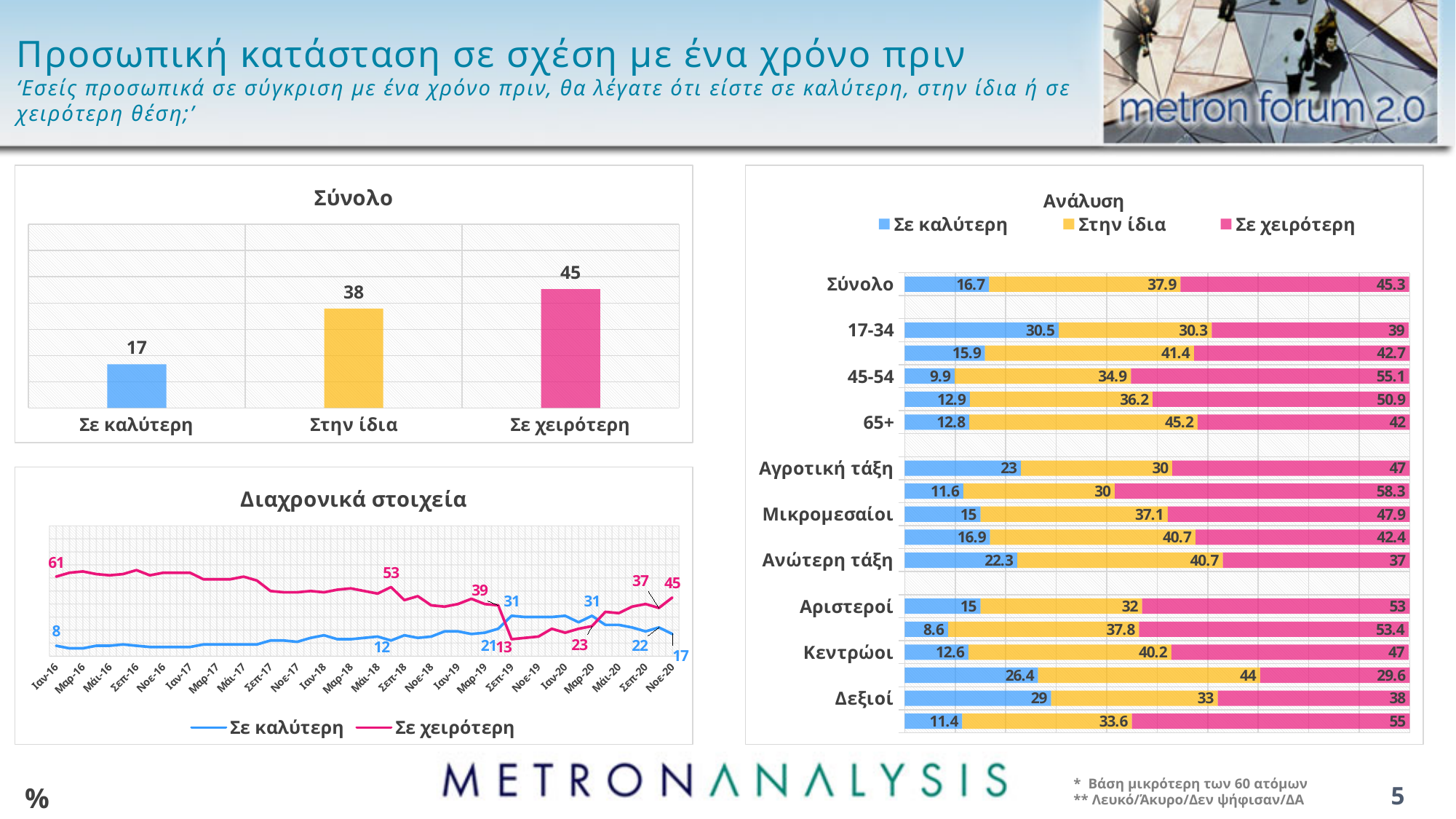
What kind of chart is the 'Σύνολο' chart? bar chart In the 'Διαχρονικά στοιχεία' chart, what is the value of 'Σε χειρότερη' at Ιαν-16? 61 In the 'Ανάλυση' chart, what is the 'Στην ίδια' value for 'Σύνολο'? 37.9 In the 'Ανάλυση' chart, which has the larger 'Σε χειρότερη' value, 'Αριστεροί' or 'Δεξιοί'? Αριστεροί How many series does the legend of the 'Ανάλυση' chart list? 3 In the 'Διαχρονικά στοιχεία' chart, does the 'Σε χειρότερη' line rise or fall from Ιαν-16 to Σεπ-19? fall In the 'Σύνολο' chart, what is the value for 'Σε χειρότερη'? 45 In the 'Σύνολο' chart, what is the difference between 'Σε χειρότερη' and 'Σε καλύτερη'? 28 In the 'Σύνολο' chart, which category has the lowest value? Σε καλύτερη In the 'Διαχρονικά στοιχεία' chart, what is the value of 'Σε καλύτερη' at Νοε-20? 17 In the 'Ανάλυση' chart, what is the total of the 'Αγροτική τάξη' bar? 100 How many series does the legend of the 'Διαχρονικά στοιχεία' chart list? 2